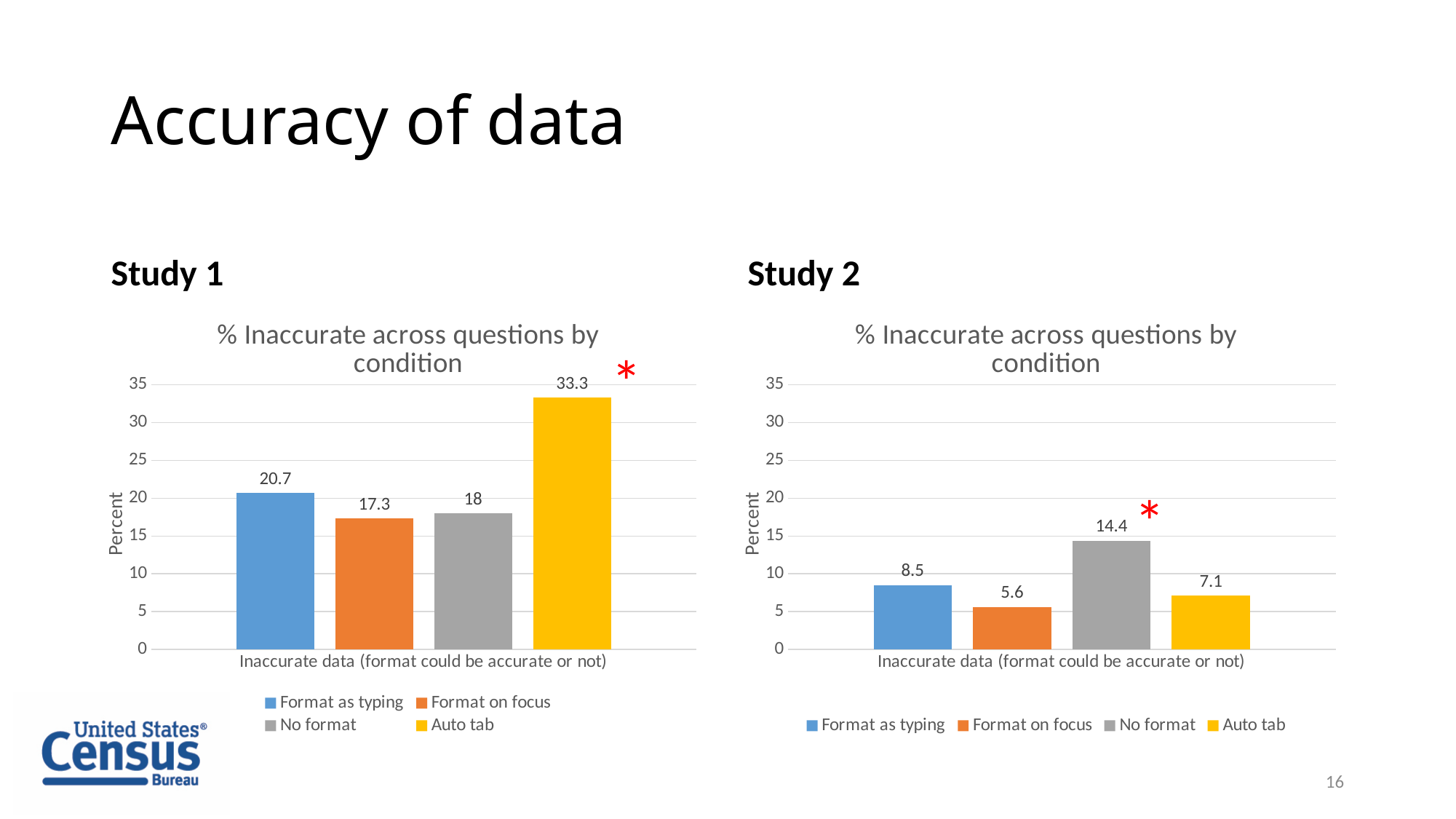
In the Study 2 chart, what is the value for No format? 14.4 In the Study 2 chart, which condition has the lowest value? Format on focus How many series does the legend of the Study 1 chart list? 4 In the Study 1 chart, what is the value for Auto tab? 33.3 In the Study 2 chart, which is larger, Format as typing or Auto tab? Format as typing In the Study 1 chart, what is the value for Format on focus? 17.3 In the Study 1 chart, which condition has the highest value? Auto tab In the Study 2 chart, what is the difference between the No format value and the Auto tab value? 7.3 What is the y-axis label on the Study 1 chart? Percent In the Study 2 chart, what is the value for Format as typing? 8.5 In the Study 1 chart, what is the difference between the Auto tab value and the Format as typing value? 12.6 What kind of chart is the Study 2 chart? Bar chart